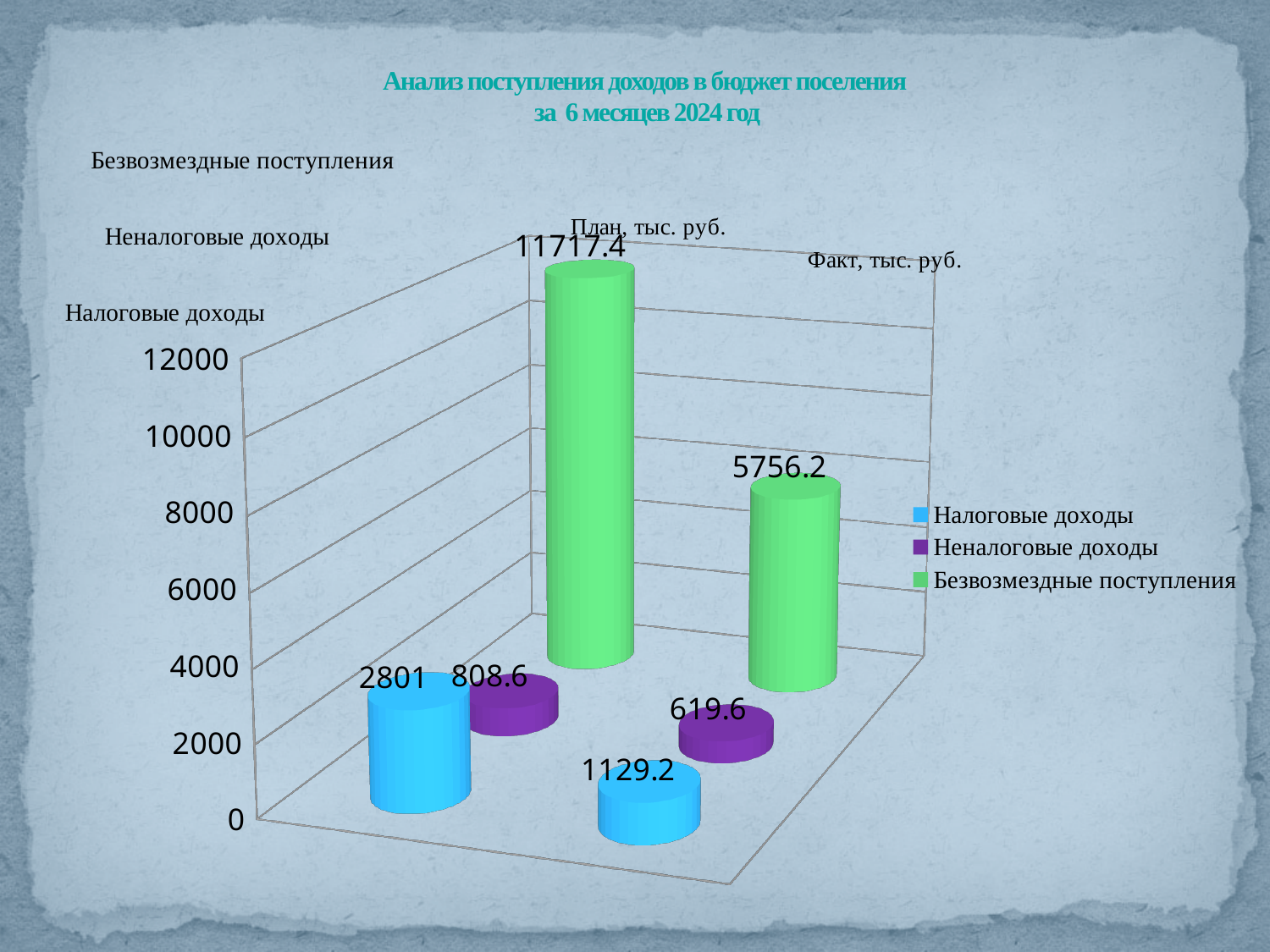
What is the difference between the planned and actual values for Безвозмездные поступления? 5961.2 What kind of chart is shown on the slide? Bar chart How many series does the legend list? 3 What is the planned value (План, тыс. руб.) for Налоговые доходы? 2801 What is the actual value (Факт, тыс. руб.) for Налоговые доходы? 1129.2 Which series has the lowest actual value (Факт, тыс. руб.)? Неналоговые доходы Is the planned value for Безвозмездные поступления greater or less than 10000? greater What is the planned value (План, тыс. руб.) for Неналоговые доходы? 808.6 Which is larger: the planned value for Налоговые доходы or the actual value for Налоговые доходы? Planned (2801) What colour represents Неналоговые доходы in the legend? Purple What is the actual value (Факт, тыс. руб.) for Безвозмездные поступления? 5756.2 Which series has the highest planned value (План, тыс. руб.)? Безвозмездные поступления